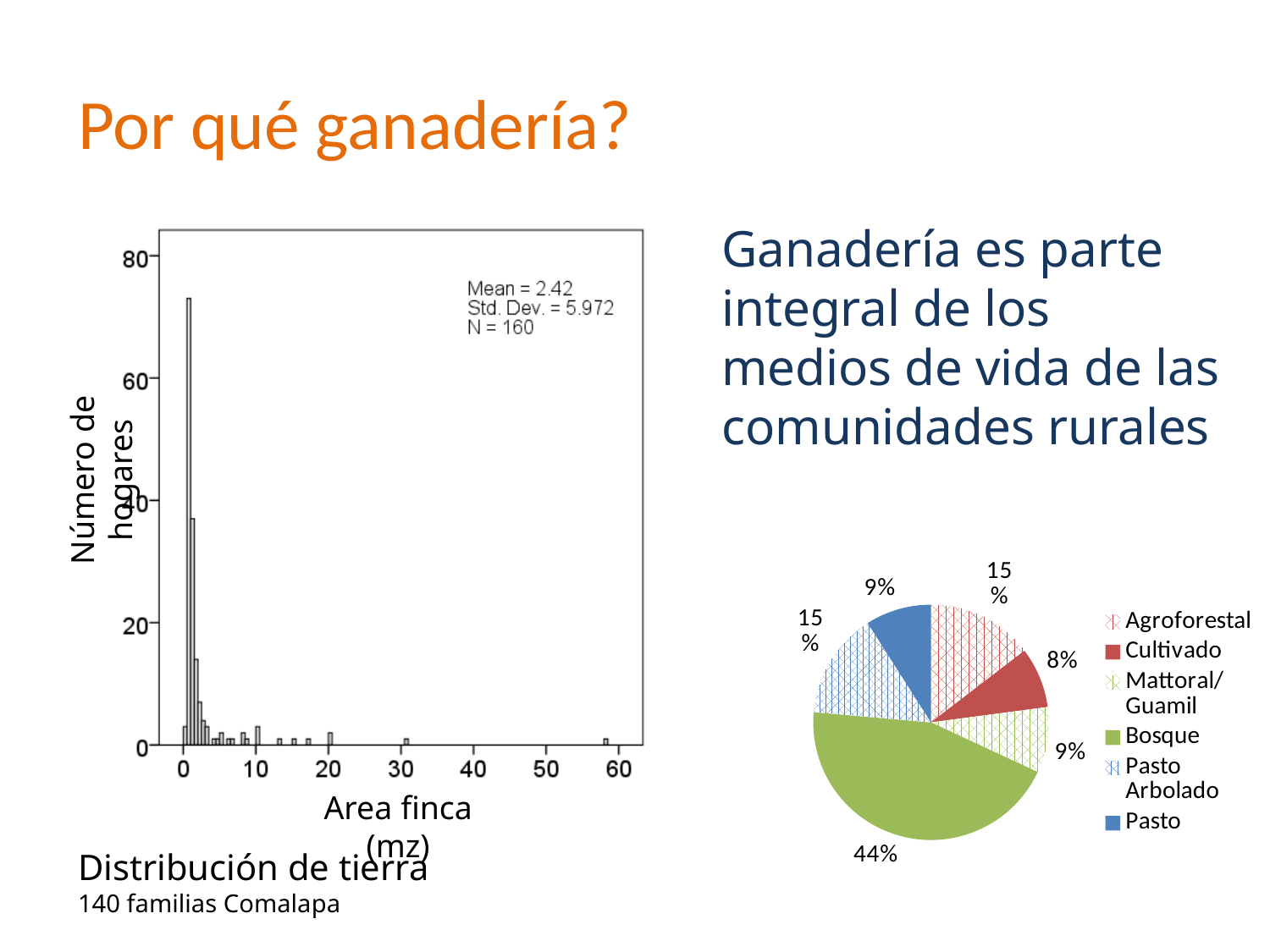
In the pie chart on the right, what share does Bosque have? 44% How many categories does the legend of the pie chart on the right list? 6 In the pie chart on the right, which category has the largest share? Bosque In the pie chart on the right, which category has the smallest share? Cultivado In the pie chart on the right, which is larger, the share of Pasto or the share of Cultivado? Pasto In the pie chart on the right, what is the difference between the shares of Bosque and Pasto Arbolado? 29% In the 'Distribución de tierra' chart on the left, is the tallest bar greater or less than 60? greater In the 'Distribución de tierra' chart on the left, what is the Mean shown in the chart? 2.42 What kind of chart is the chart on the right of the slide? Pie chart In the 'Distribución de tierra' chart on the left, what is the value of N shown in the chart? 160 In the pie chart on the right, what share does Cultivado have? 8% In the pie chart on the right, what share does Agroforestal have? 15%